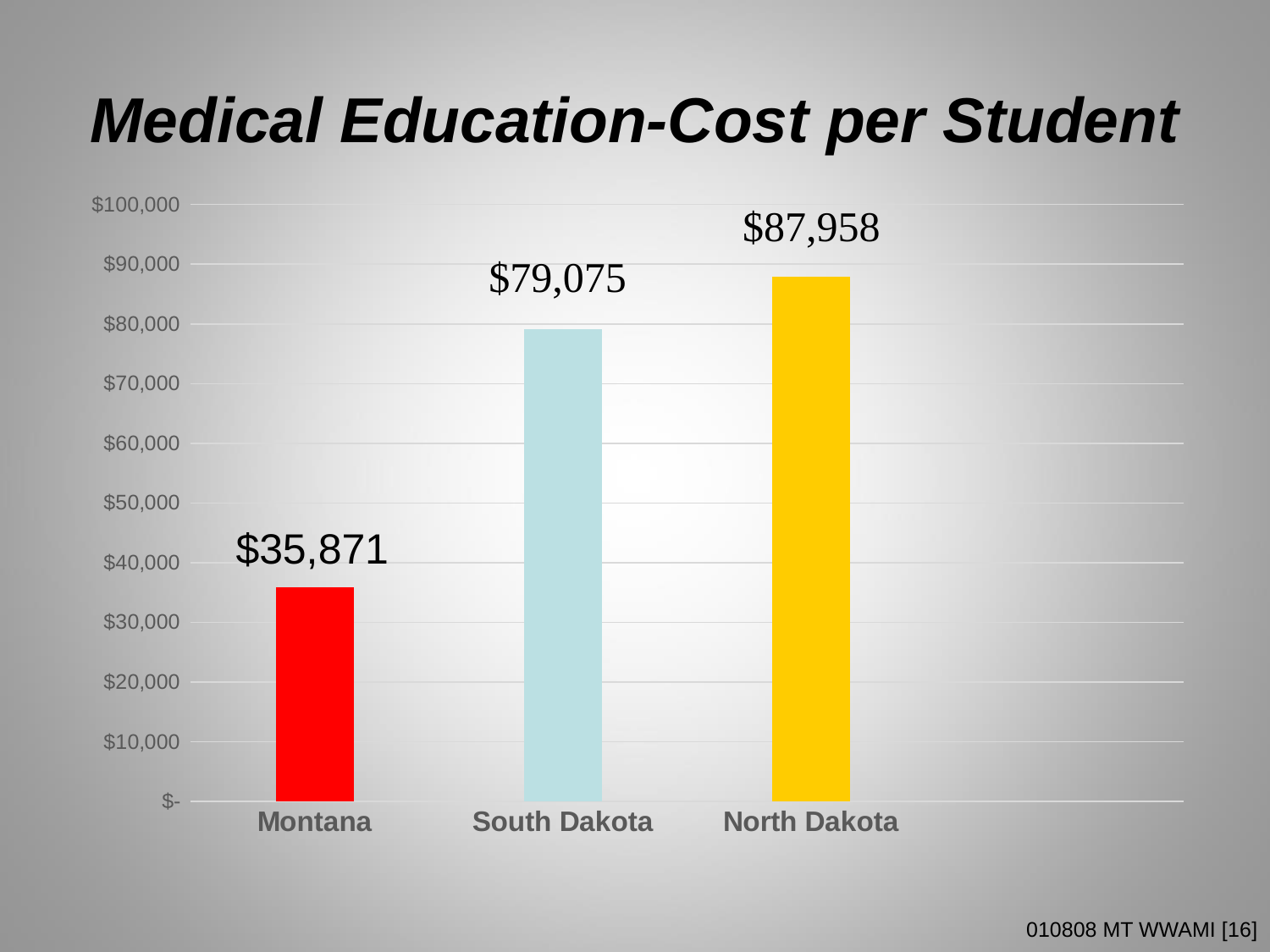
What is the medical education cost per student for Montana? $35,871 How many states are shown in the chart? 3 Which has a higher cost per student, South Dakota or Montana? South Dakota What is the medical education cost per student for South Dakota? $79,075 What kind of chart is shown on the slide? Bar chart What colour is the bar for Montana? Red What is the difference in cost per student between North Dakota and South Dakota? $8,883 What is the difference in cost per student between North Dakota and Montana? $52,087 Which state has the highest cost per student? North Dakota Is the value for South Dakota greater or less than $80,000? less Which state has the lowest cost per student? Montana What is the medical education cost per student for North Dakota? $87,958